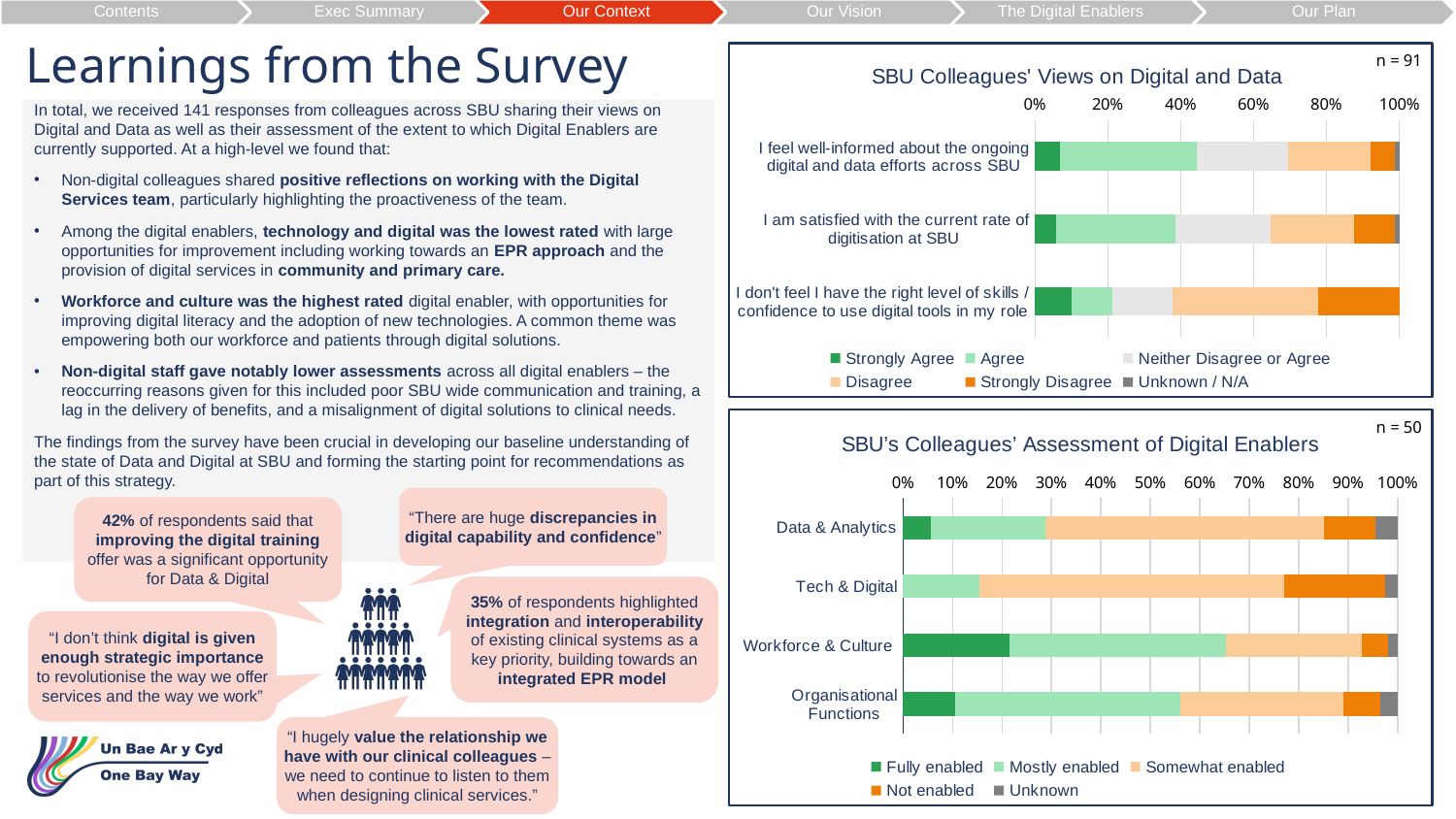
What kind of chart is 'SBU Colleagues' Views on Digital and Data'? Stacked bar chart What is the sample size (n) shown for the 'SBU Colleagues' Views on Digital and Data' chart? n = 91 In the 'SBU's Colleagues' Assessment of Digital Enablers' chart, which has the larger Not enabled segment, Tech & Digital or Data & Analytics? Tech & Digital In the 'SBU Colleagues' Views on Digital and Data' chart, is the Strongly Agree share for 'I am satisfied with the current rate of digitisation at SBU' greater or less than 20%? less How many digital enablers are plotted in the 'SBU's Colleagues' Assessment of Digital Enablers' chart? 4 How many series does the legend of the 'SBU's Colleagues' Assessment of Digital Enablers' chart list? 5 In the 'SBU Colleagues' Views on Digital and Data' chart, which statement has the largest Strongly Disagree segment? I don't feel I have the right level of skills / confidence to use digital tools in my role In the 'SBU's Colleagues' Assessment of Digital Enablers' chart, is the Somewhat enabled share for Tech & Digital greater or less than 50%? greater How many series does the legend of the 'SBU Colleagues' Views on Digital and Data' chart list? 6 In the 'SBU's Colleagues' Assessment of Digital Enablers' chart, which enabler has the largest Fully enabled segment? Workforce & Culture How many statements are plotted in the 'SBU Colleagues' Views on Digital and Data' chart? 3 What is the sample size (n) shown for the 'SBU's Colleagues' Assessment of Digital Enablers' chart? n = 50